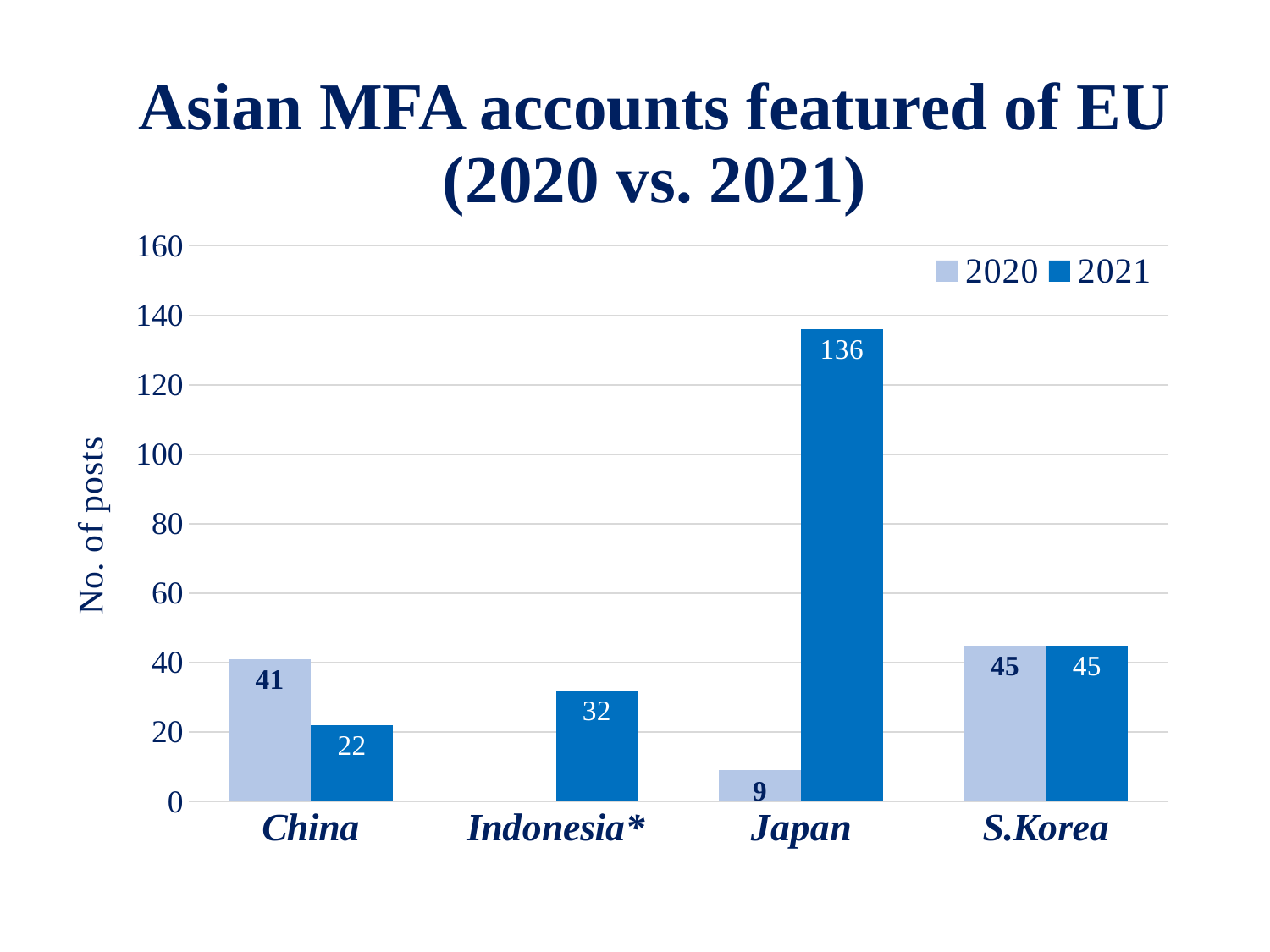
What is the difference between the 2020 and 2021 values for China? 19 What is the value for Japan in the 2021 series? 136 What is the difference between the 2021 and 2020 values for Japan? 127 Which is larger for China: the 2020 value or the 2021 value? 2020 What is the value for China in the 2020 series? 41 What is the value for Japan in the 2020 series? 9 Which category has the lowest value in the 2020 series among those with a 2020 bar? Japan How many categories are shown on the x axis? 4 What is the value for Indonesia* in the 2021 series? 32 Which category has the highest value in the 2021 series? Japan How many series does the legend list? 2 What kind of chart is shown on the slide? Bar chart